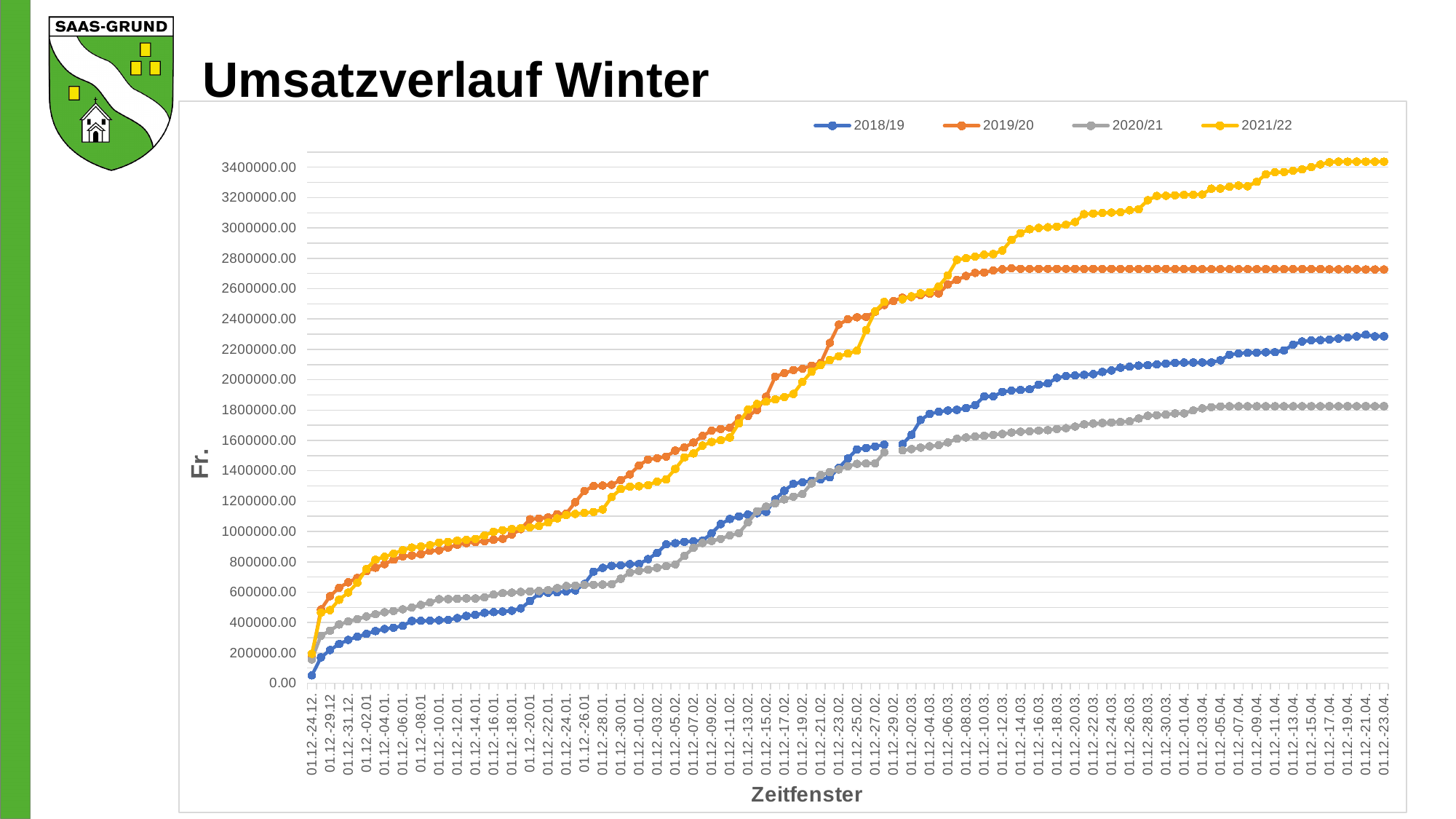
How many series does the legend list? 4 Do the values of the 2018/19 series rise or fall along the x axis? rise At 01.12.-23.04., which series has the larger value, 2019/20 or 2018/19? 2019/20 Which series has the lowest value at the last time window (01.12.-23.04.)? 2020/21 Is the value for 2018/19 at 01.12.-23.04. greater or less than 2400000.00? less Which series starts at the lowest value at the first time window (01.12.-24.12.)? 2018/19 What is the label of the x axis? Zeitfenster Is the value for 2021/22 at 01.12.-23.04. greater or less than 3200000.00? greater What is the title of the chart? Umsatzverlauf Winter What kind of chart is shown on the slide? line chart Is the value for 2020/21 at 01.12.-23.04. greater or less than 1600000.00? greater Which series reaches the highest value at the last time window (01.12.-23.04.)? 2021/22